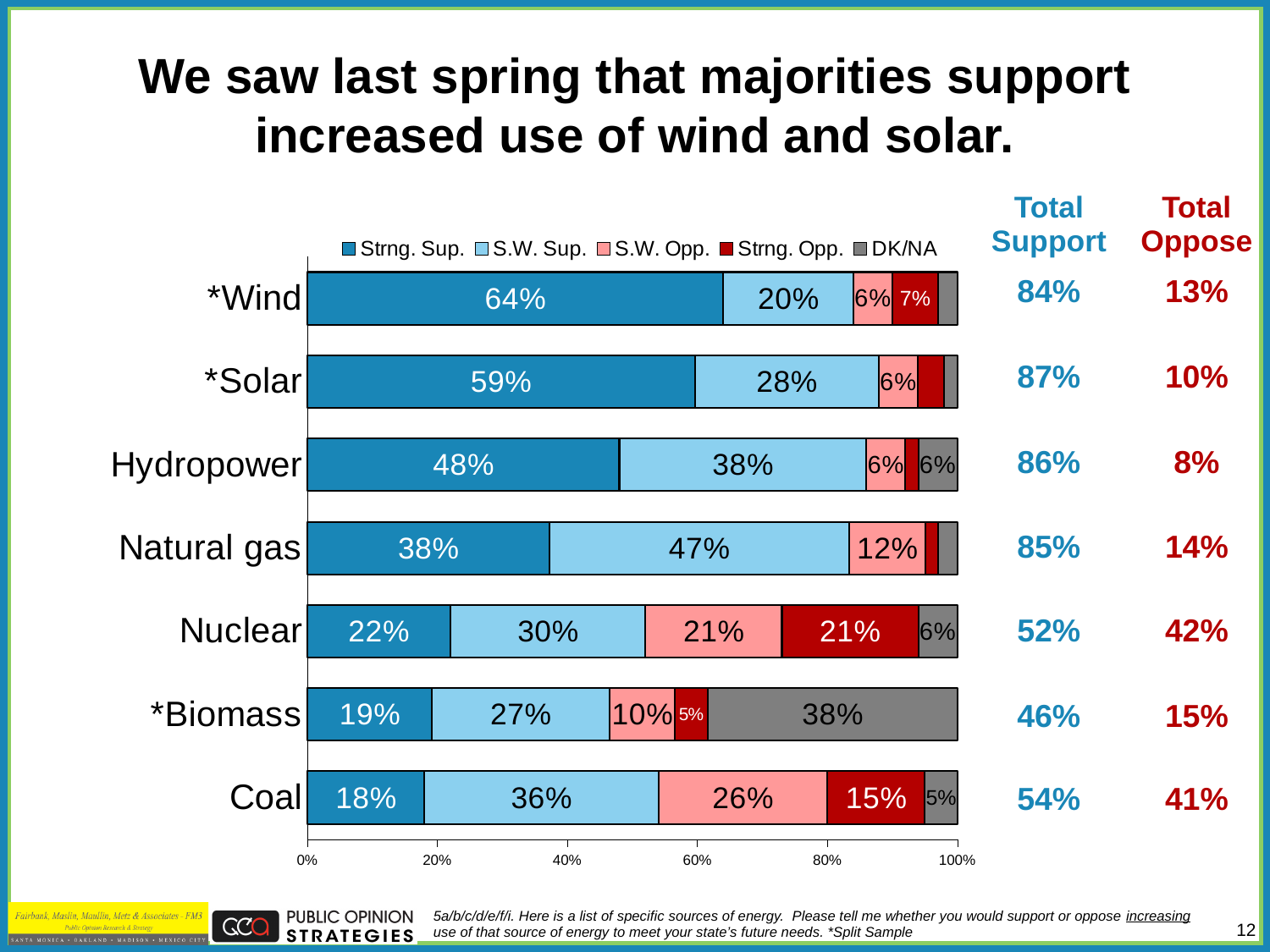
Which energy source has the lowest Strng. Sup. value? Coal How many energy sources are shown in the chart? 7 How many series does the legend list? 5 Which energy source has the largest DK/NA segment? *Biomass How many percentage points higher is the Strng. Opp. value for Nuclear than for Coal? 6 percentage points Which has a larger S.W. Sup. value, Hydropower or *Solar? Hydropower What is the DK/NA value for *Biomass? 38% What is the combined Strng. Sup. and S.W. Sup. value for Coal? 54% What is the S.W. Sup. value for Natural gas? 47% What kind of chart is shown on the slide? Stacked bar chart What percentage strongly support increased use of wind (Strng. Sup. for *Wind)? 64% Which energy source has the highest Strng. Sup. value? *Wind